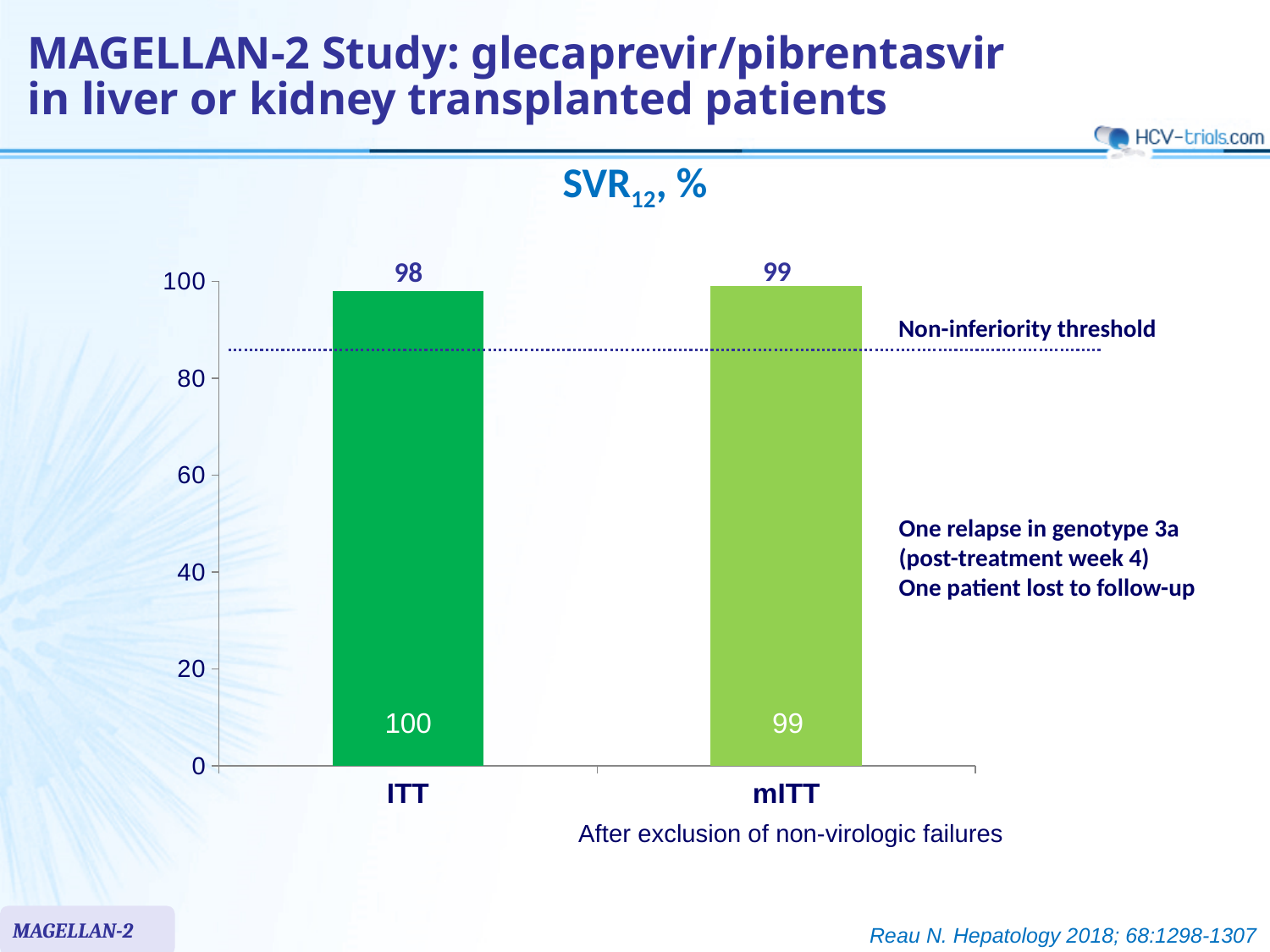
What is the SVR12 value for the ITT group? 98 What is the SVR12 value for the mITT group? 99 What is the difference in SVR12 between the mITT and ITT groups? 1 What is the title of the chart? SVR12, % What does the dotted horizontal line across the chart represent? Non-inferiority threshold How many bars are plotted in the chart? 2 What number is printed inside the mITT bar? 99 What number is printed inside the ITT bar? 100 What kind of chart is shown on the slide? Bar chart Which group has the higher SVR12 value, ITT or mITT? mITT Is the SVR12 value for the ITT group greater or less than 80? greater What is the highest value shown on the y axis? 100